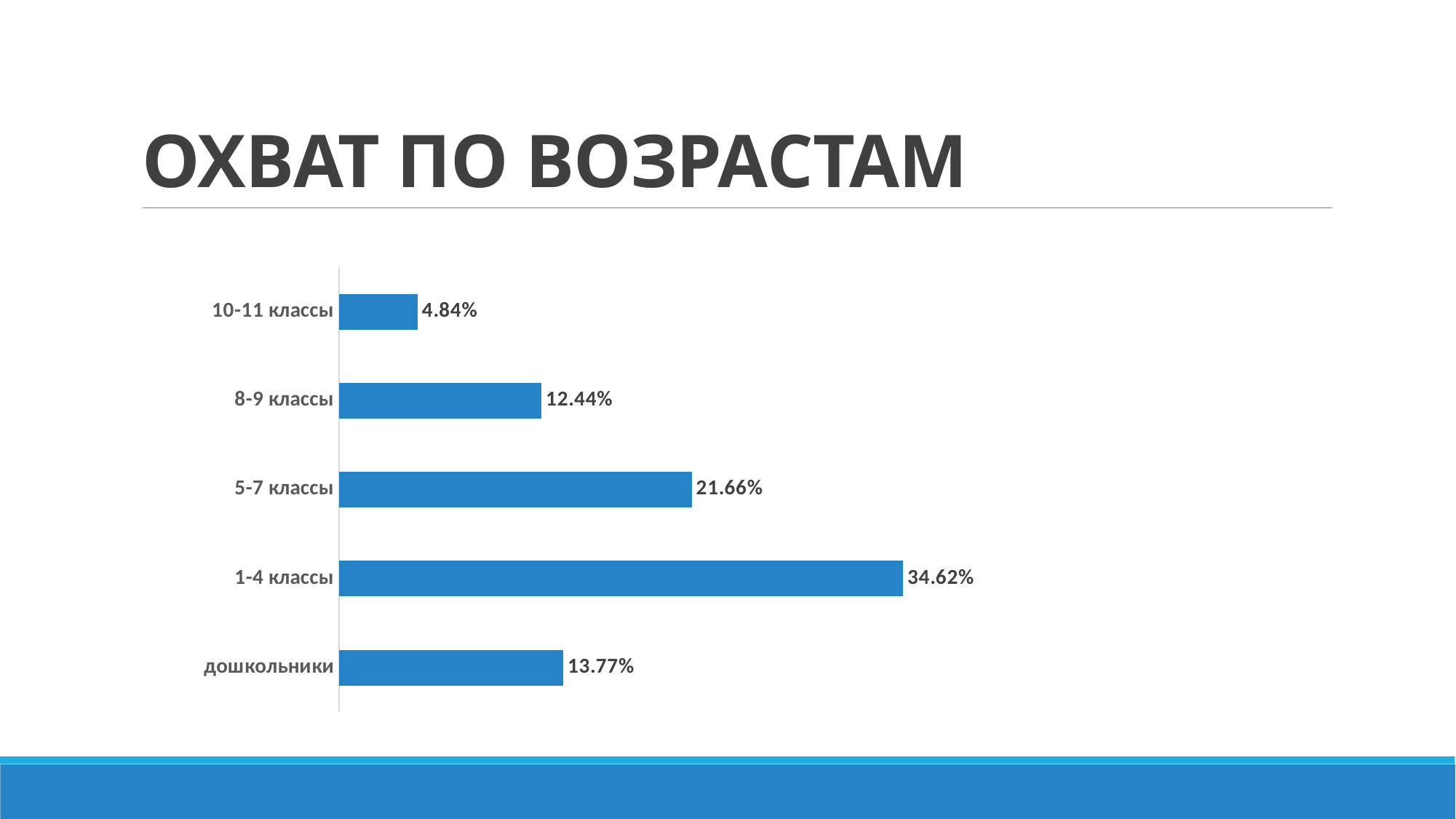
How many categories are shown in the chart? 5 Which is larger, the value for 5-7 классы or the value for 8-9 классы? 5-7 классы What is the value for дошкольники? 13.77% What is the value for 1-4 классы? 34.62% What is the value for 8-9 классы? 12.44% What kind of chart is shown on the slide? bar chart What is the difference between the values for дошкольники and 8-9 классы? 1.33% What is the title of the slide? ОХВАТ ПО ВОЗРАСТАМ Which category has the highest value? 1-4 классы What is the value for 10-11 классы? 4.84% Which category has the lowest value? 10-11 классы What is the difference between the values for 1-4 классы and 5-7 классы? 12.96%